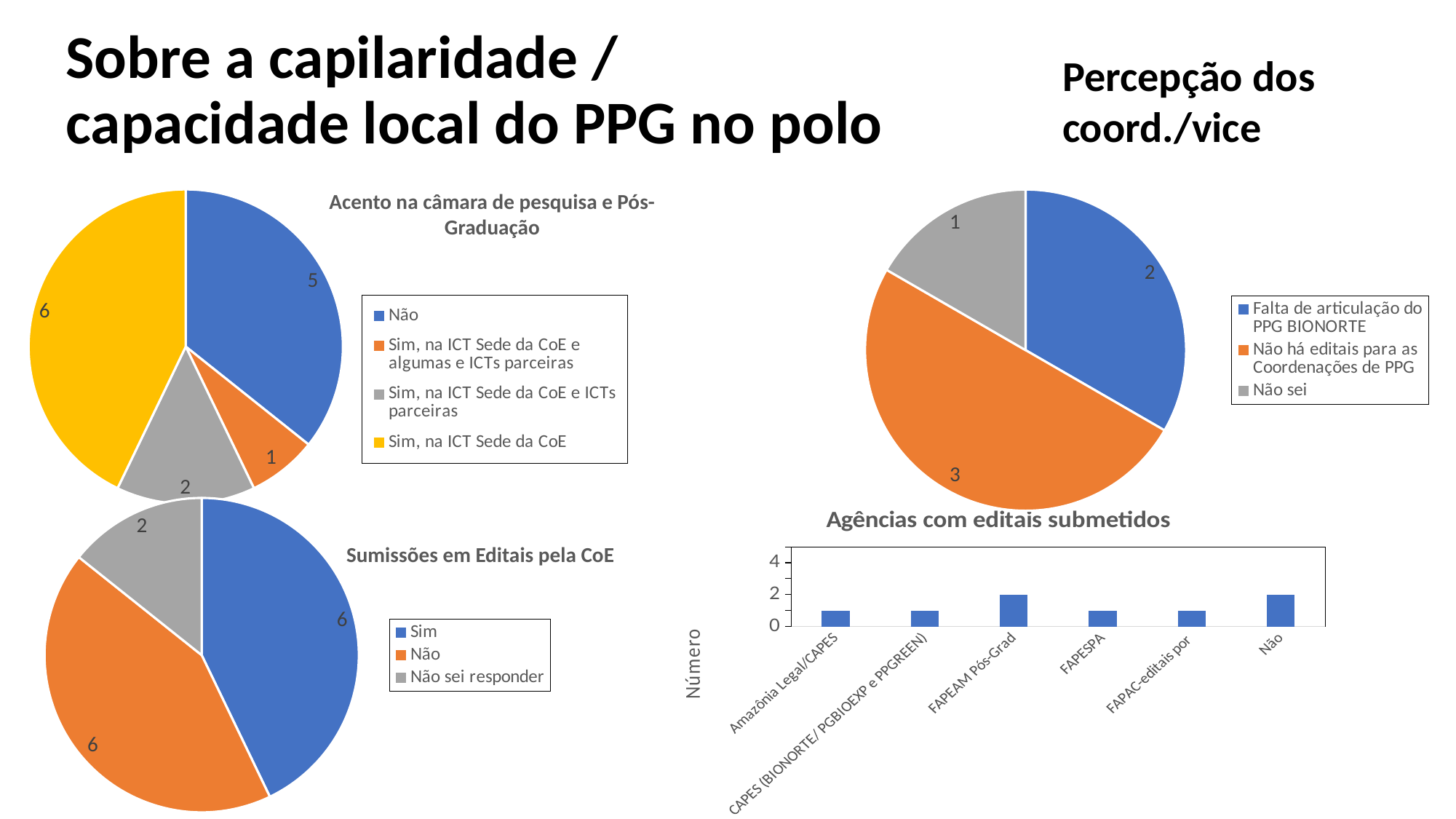
In the pie chart at the top right of the slide (under "Percepção dos coord./vice"), what share of the pie does "Falta de articulação do PPG BIONORTE" represent? 1/3 In the pie chart titled "Sumissões em Editais pela CoE", what is the difference between the values for "Sim" and "Não sei responder"? 4 In the pie chart titled "Acento na câmara de pesquisa e Pós-Graduação", which category has the smallest slice? Sim, na ICT Sede da CoE e algumas e ICTs parceiras In the pie chart at the top right of the slide (under "Percepção dos coord./vice"), what is the value for "Não há editais para as Coordenações de PPG"? 3 In the pie chart titled "Sumissões em Editais pela CoE", what is the total of all slices? 14 In the pie chart at the top right of the slide (under "Percepção dos coord./vice"), which category has the smallest slice? Não sei In the pie chart titled "Acento na câmara de pesquisa e Pós-Graduação", how many categories does the legend list? 4 In the pie chart titled "Sumissões em Editais pela CoE", what is the value for "Não sei responder"? 2 What kind of chart is "Agências com editais submetidos"? Bar chart In the pie chart titled "Acento na câmara de pesquisa e Pós-Graduação", what is the value for "Não"? 5 In the pie chart titled "Acento na câmara de pesquisa e Pós-Graduação", which category has the largest slice? Sim, na ICT Sede da CoE In the chart titled "Agências com editais submetidos", what is the value for "FAPEAM Pós-Grad"? 2